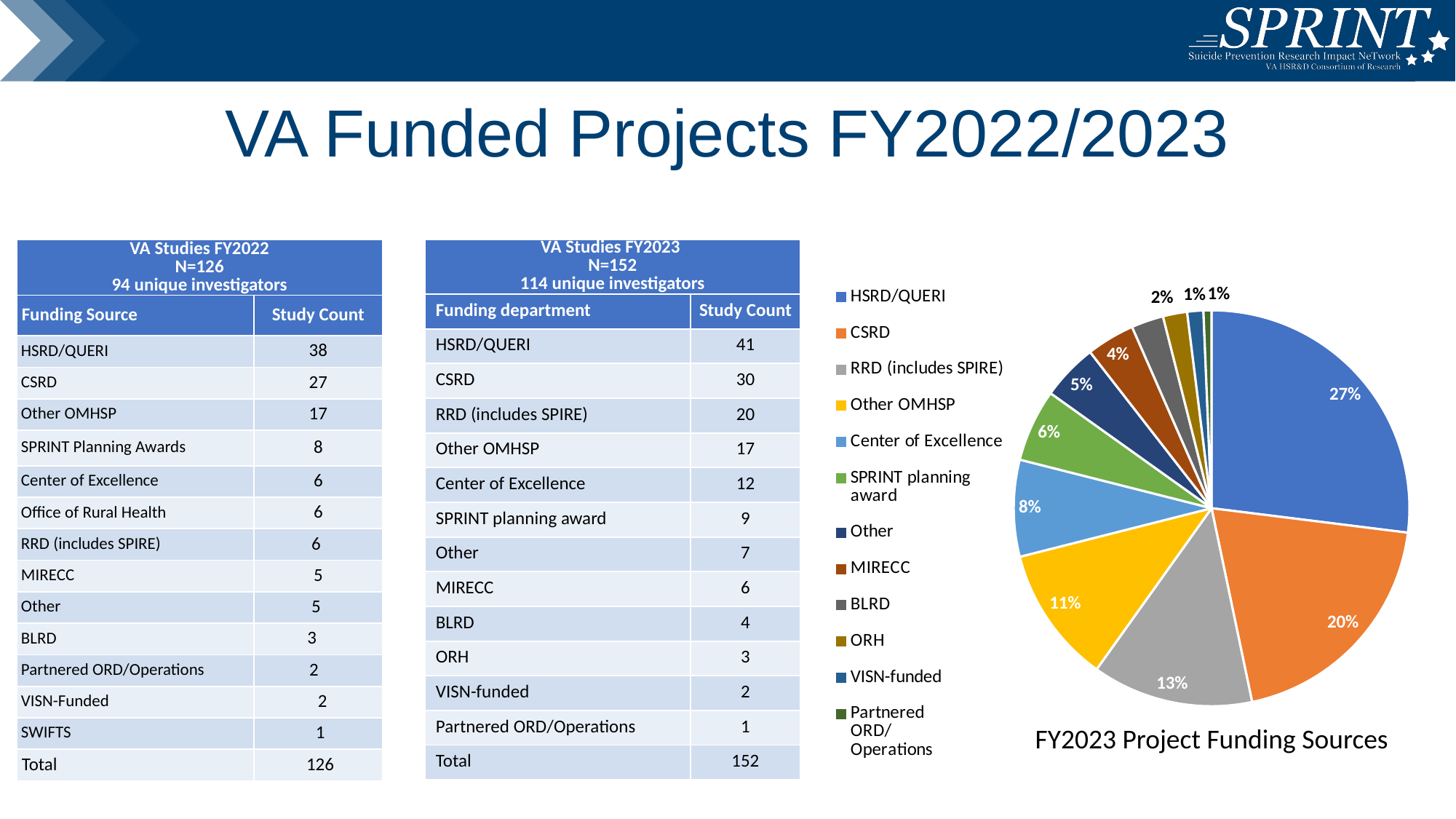
In the FY2023 Project Funding Sources pie chart, which slice is larger: SPRINT planning award or Other? SPRINT planning award How many entries does the legend of the FY2023 Project Funding Sources pie chart list? 12 In the FY2023 Project Funding Sources pie chart, how much larger is the HSRD/QUERI share than the CSRD share? 7% In the FY2023 Project Funding Sources pie chart, what share does RRD (includes SPIRE) have? 13% What is the title of the pie chart? FY2023 Project Funding Sources In the FY2023 Project Funding Sources pie chart, what share does CSRD have? 20% Which funding source has the largest slice in the FY2023 Project Funding Sources pie chart? HSRD/QUERI In the FY2023 Project Funding Sources pie chart, what share does Center of Excellence have? 8% What kind of chart is shown on the slide? pie chart